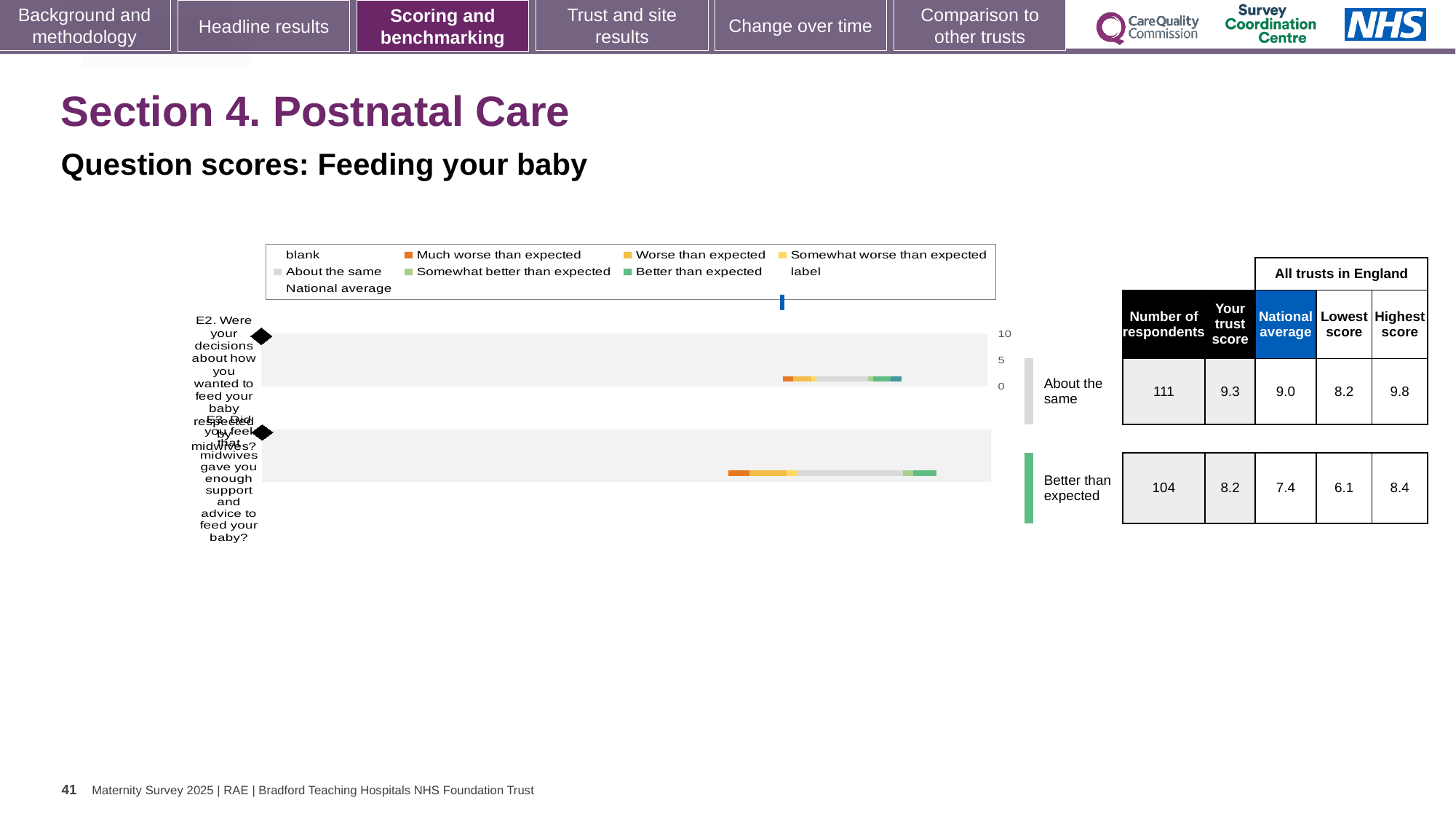
What is the trust score for E2 (decisions about how you wanted to feed your baby respected by midwives)? 9.3 What kind of chart is used to show the question scores for Feeding your baby? bar chart How many respondents answered question E3? 104 What is the difference between the highest and lowest scores for E2 across all trusts in England? 1.6 Which question has the higher trust score, E2 or E3? E2 How many questions are plotted in the Feeding your baby chart? 2 What is the highest score among all trusts in England for E2? 9.8 Which benchmark category is shown for question E3? Better than expected By how much does the trust score for E3 exceed the national average for E3? 0.8 Which benchmark category is shown for question E2? About the same What is the trust score for E3 (midwives gave you enough support and advice to feed your baby)? 8.2 What is the national average score for E2? 9.0